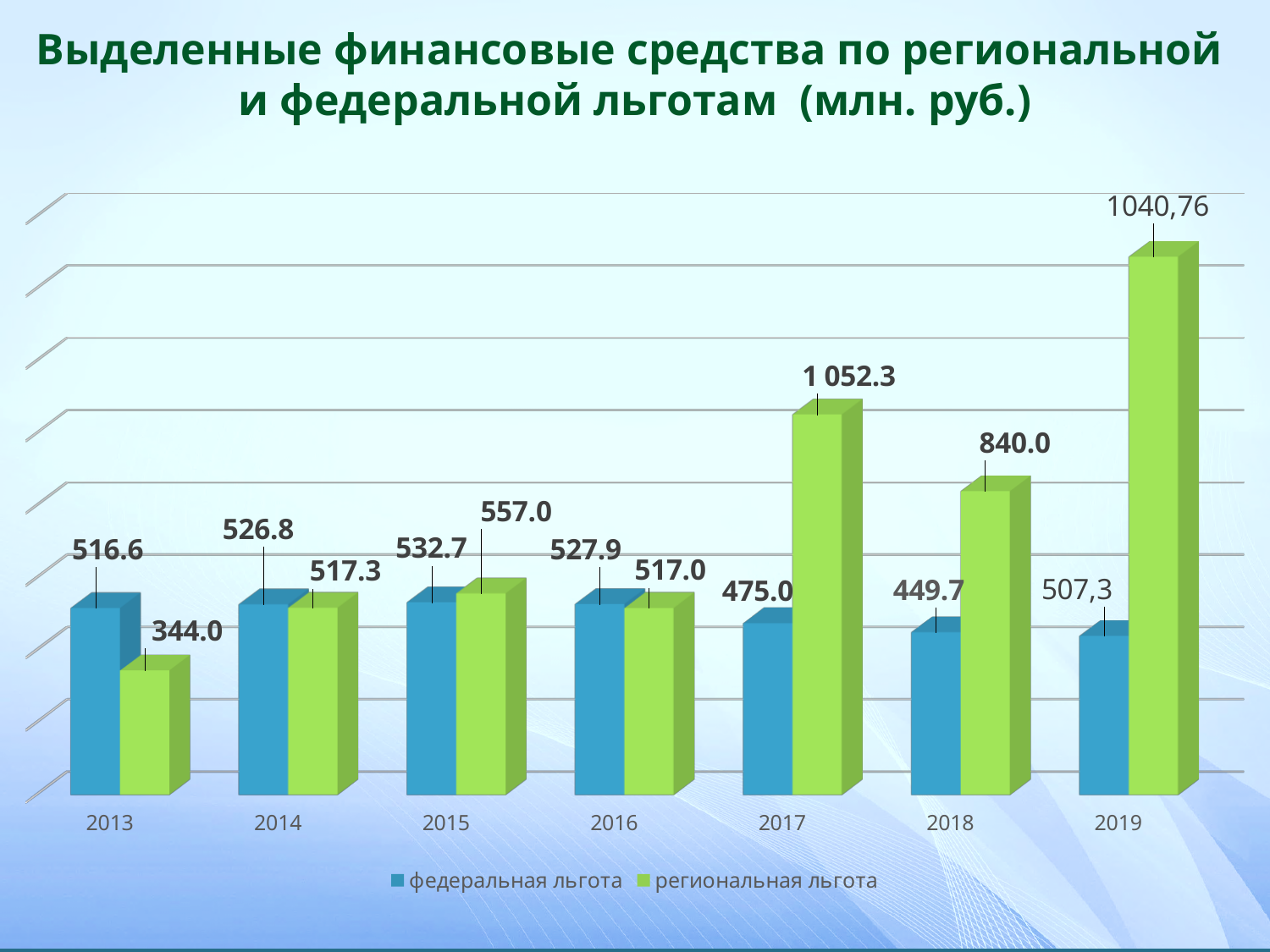
What is the value for региональная льгота in 2017? 1 052.3 What is the value for региональная льгота in 2019? 1040,76 In 2017, which is larger: федеральная льгота or региональная льгота? региональная льгота Does the value for федеральная льгота rise or fall from 2015 to 2018? fall How many series does the legend list? 2 How many years are shown on the x axis? 7 What is the value for федеральная льгота in 2018? 449.7 What is the value for федеральная льгота in 2013? 516.6 What is the difference between федеральная льгота and региональная льгота in 2013? 172.6 What is the difference between региональная льгота and федеральная льгота in 2018? 390.3 In which year is the value for региональная льгота the lowest? 2013